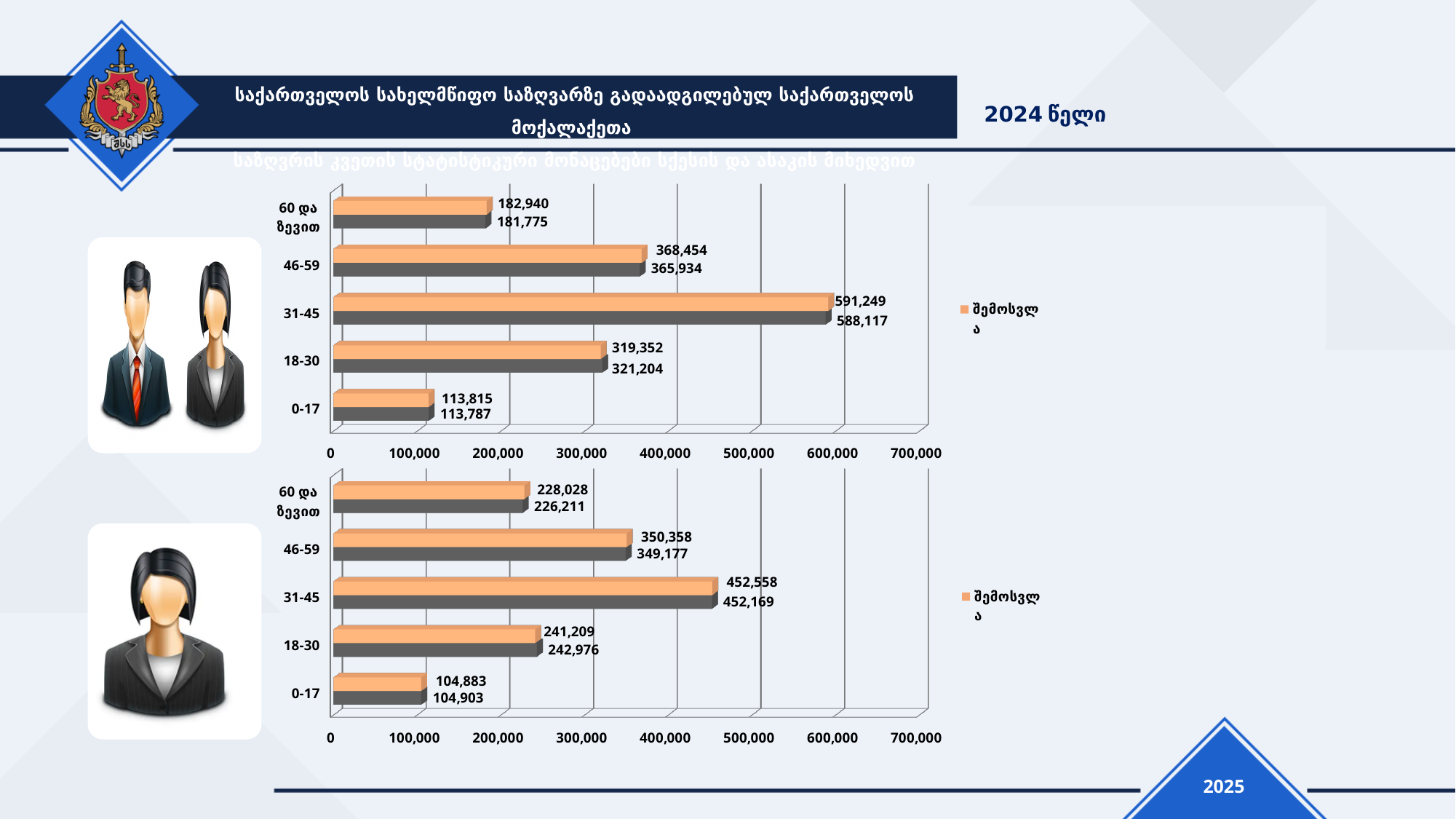
In the bottom chart, which age group has the lowest orange bar value? 0-17 How many age group categories are shown in the bottom chart? 5 In the top chart, is the orange bar value for 31-45 greater or less than 500,000? greater In the top chart, what is the difference between the orange bar values for 31-45 and 46-59? 222,795 What type of chart is the top chart? bar chart In the top chart, which age group has the highest orange bar value? 31-45 In the top chart, what is the value of the grey bar for the 18-30 age group? 321,204 In the bottom chart, what is the value of the orange bar for the '60 და ზევით' age group? 228,028 In the bottom chart, what is the value of the grey bar for the 0-17 age group? 104,903 In the top chart, which has the larger orange bar value: 18-30 or '60 და ზევით'? 18-30 In the top chart, what is the value of the orange bar for the 31-45 age group? 591,249 In the bottom chart, what is the difference between the orange bar values for 31-45 and 18-30? 211,349